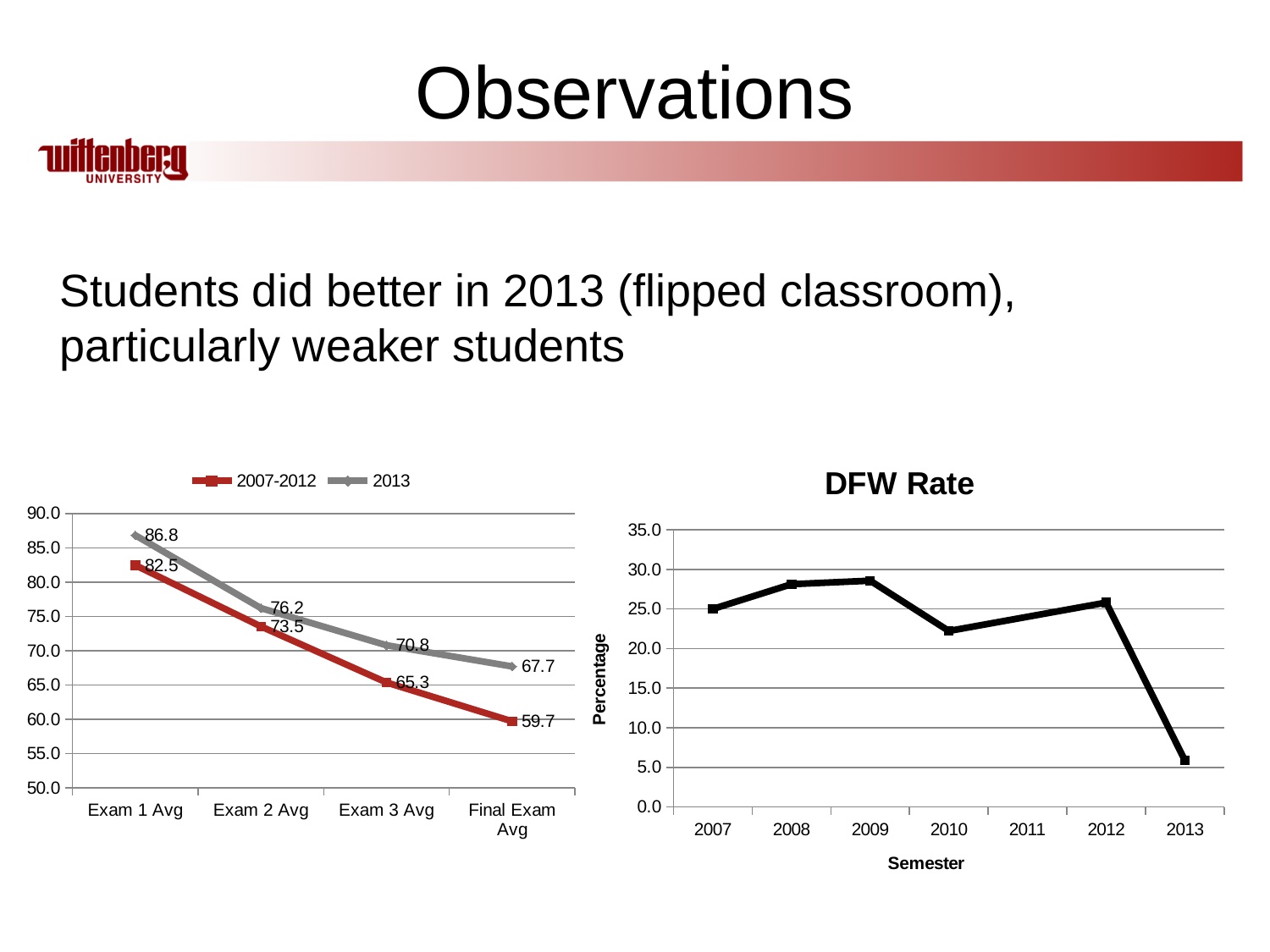
In the DFW Rate chart, is the value for 2013 greater or less than 10.0? less In the DFW Rate chart, what is the label of the y axis? Percentage In the left chart, how many series does the legend list? 2 In the left chart, how many exam categories are shown on the x axis? 4 In the left chart, what is the 2007-2012 value for Exam 3 Avg? 65.3 In the left chart, which series has the higher value for Exam 2 Avg, 2007-2012 or 2013? 2013 In the left chart, do the 2007-2012 values rise or fall from Exam 1 Avg to Final Exam Avg? fall In the DFW Rate chart, which year has the lowest percentage? 2013 In the left chart, what is the 2007-2012 value for Final Exam Avg? 59.7 In the left chart, what is the 2013 value for Exam 1 Avg? 86.8 In the left chart, what is the difference between the 2013 and 2007-2012 values for Final Exam Avg? 8.0 What kind of chart is the DFW Rate chart? line chart